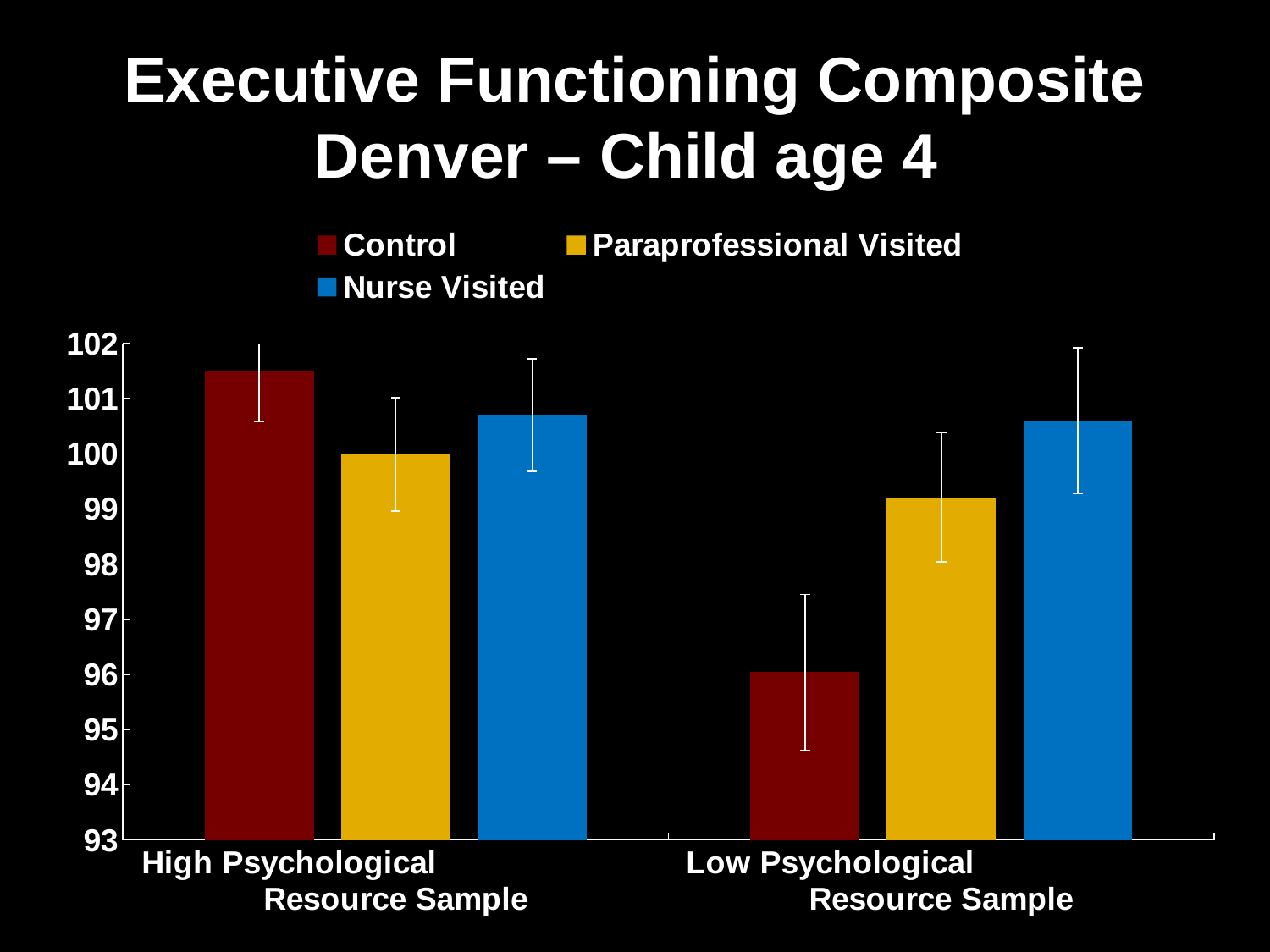
Is the Nurse Visited value for the Low Psychological Resource Sample greater or less than 100? greater Which colour represents the Nurse Visited series? blue What kind of chart is shown on the slide? bar chart Is the Control value for the High Psychological Resource Sample greater or less than 101? greater How many series does the legend list? 3 Is the Paraprofessional Visited value for the Low Psychological Resource Sample greater or less than 100? less Which series has the highest value in the High Psychological Resource Sample? Control How many sample groups are shown on the x axis? 2 Which is larger: the Control value for the High Psychological Resource Sample or the Control value for the Low Psychological Resource Sample? High Psychological Resource Sample Which series has the lowest value in the Low Psychological Resource Sample? Control What is the title of the chart? Executive Functioning Composite Denver – Child age 4